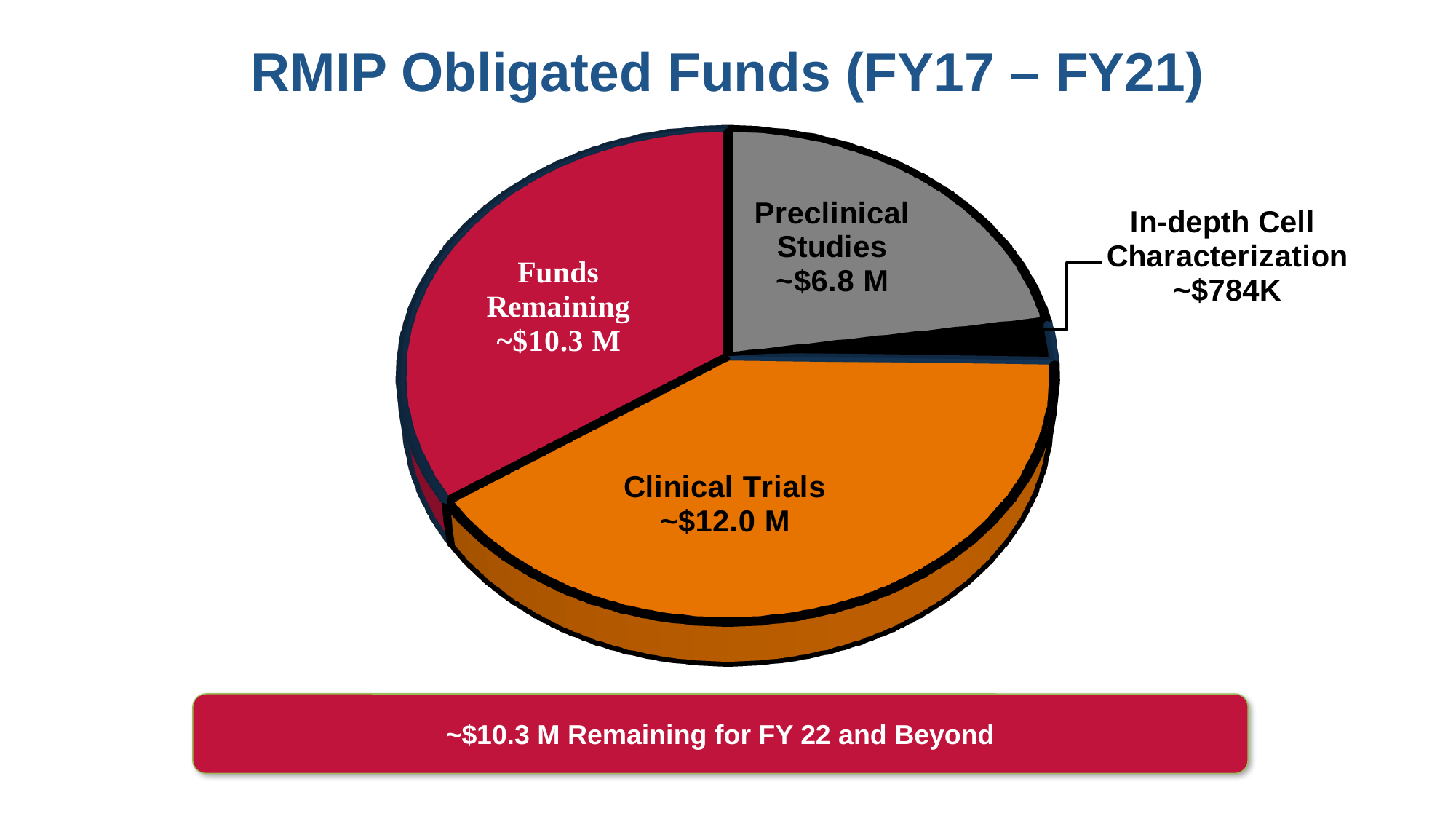
What value is shown for the In-depth Cell Characterization slice? ~$784K What value is shown for the Clinical Trials slice? ~$12.0 M Which is larger, Funds Remaining or Preclinical Studies? Funds Remaining How many slices does the pie chart have? 4 What value is shown for the Preclinical Studies slice? ~$6.8 M Which slice of the pie chart is the smallest? In-depth Cell Characterization What kind of chart is shown on the slide? Pie chart Which slice of the pie chart is the largest? Clinical Trials What value is shown for the Funds Remaining slice? ~$10.3 M What colour is the Clinical Trials slice? Orange Which is larger, Clinical Trials or Funds Remaining? Clinical Trials What is the title of the chart? RMIP Obligated Funds (FY17 – FY21)